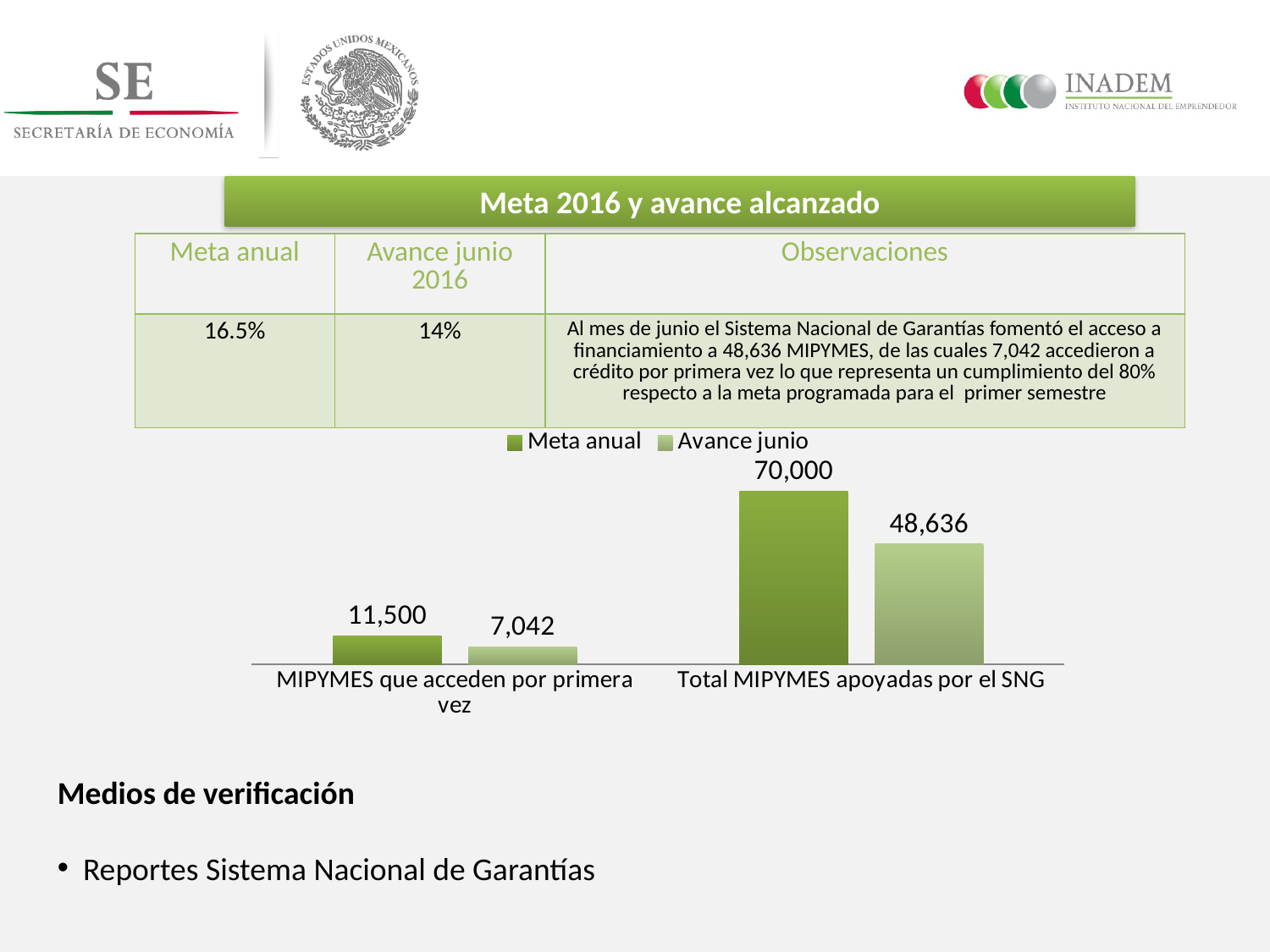
What is the difference between the Meta anual and Avance junio values for MIPYMES que acceden por primera vez? 4,458 What is the Avance junio value for MIPYMES que acceden por primera vez? 7,042 How many categories are shown on the x axis of the chart? 2 Which category has the highest Meta anual value? Total MIPYMES apoyadas por el SNG How many series does the chart legend list? 2 What is the Meta anual value for Total MIPYMES apoyadas por el SNG? 70,000 Which category has the lowest Avance junio value? MIPYMES que acceden por primera vez What is the difference between the Meta anual and Avance junio values for Total MIPYMES apoyadas por el SNG? 21,364 What kind of chart is shown on the slide? Bar chart What is the Meta anual value for MIPYMES que acceden por primera vez? 11,500 Which is larger for Total MIPYMES apoyadas por el SNG: Meta anual or Avance junio? Meta anual What is the Avance junio value for Total MIPYMES apoyadas por el SNG? 48,636